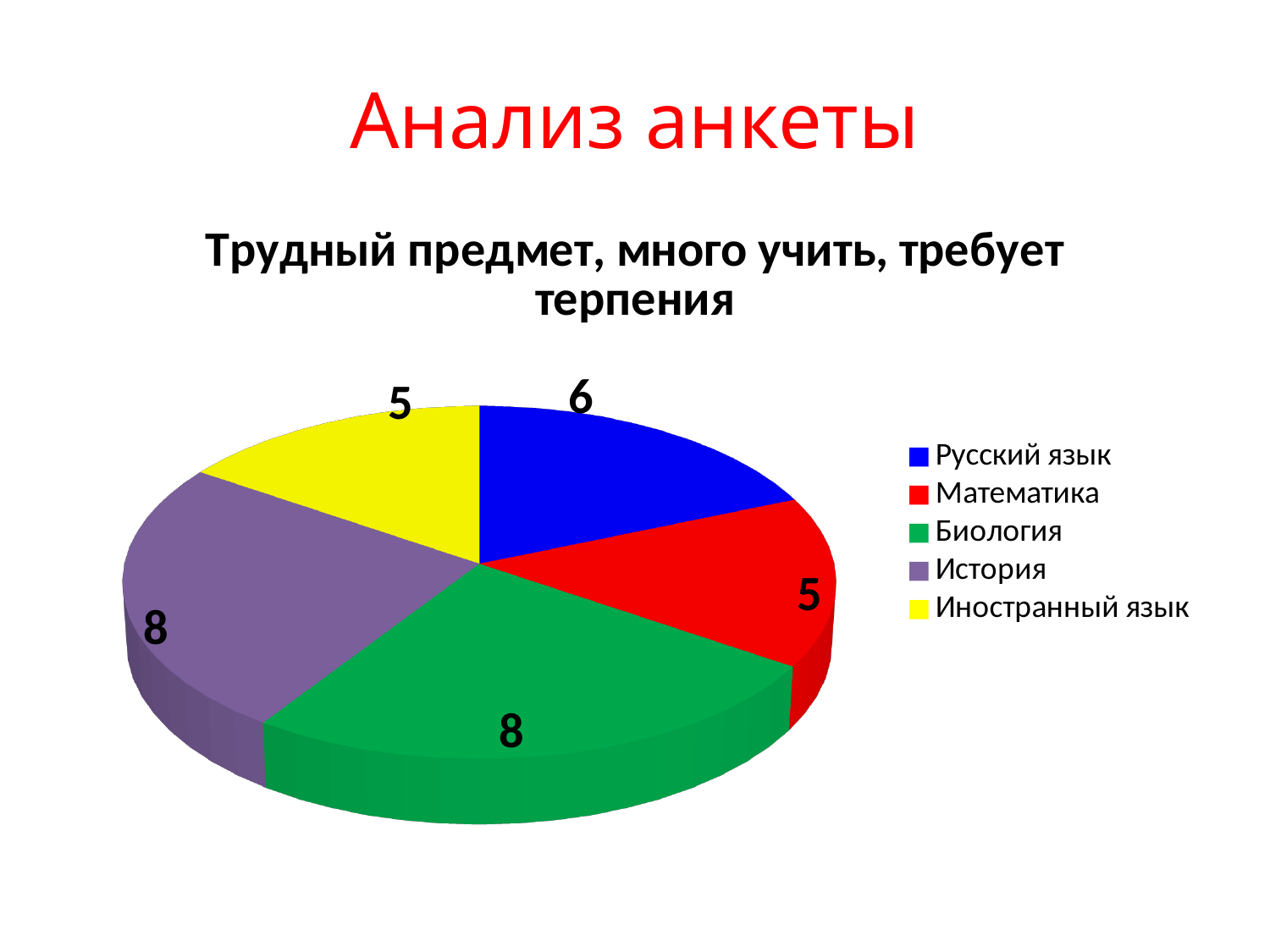
What is the difference between the value for История and the value for Иностранный язык? 3 What share of the pie does Биология represent? 25% What is the title of the pie chart? Трудный предмет, много учить, требует терпения Which colour represents История in the legend? purple What is the difference between the value for Русский язык and the value for Математика? 1 What is the value for Биология? 8 What kind of chart is shown on the slide? pie chart What is the value for Математика? 5 What is the value for Иностранный язык? 5 What is the value for Русский язык? 6 How many categories does the pie chart have? 5 Which is larger, the value for Русский язык or the value for Математика? Русский язык